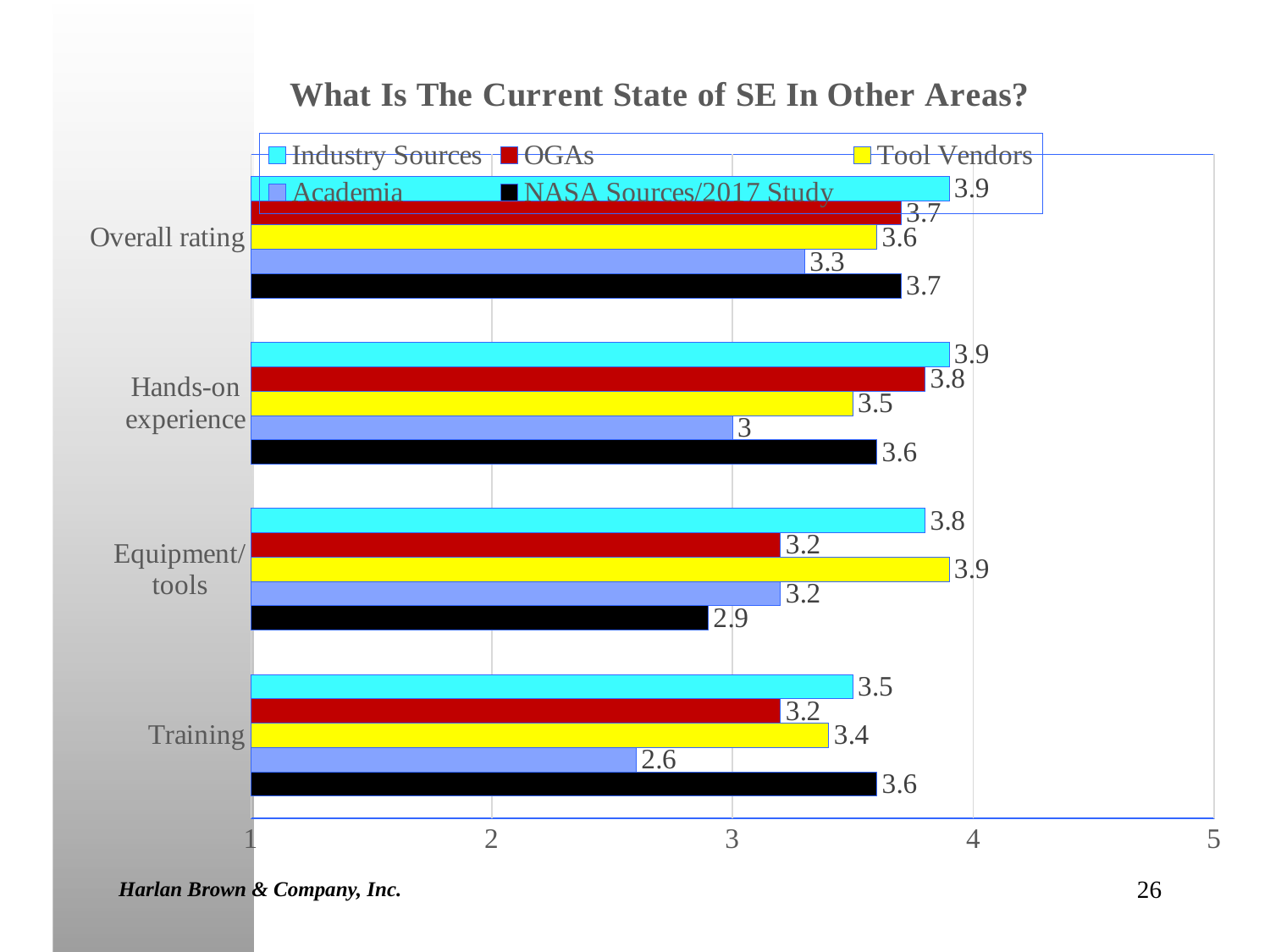
What is the Academia value for Training? 2.6 What is the difference between the Industry Sources and Academia values for Hands-on experience? 0.9 How many categories are shown on the chart? 4 For Training, which is larger: the OGAs value or the NASA Sources/2017 Study value? NASA Sources/2017 Study Which series has the highest value for Equipment/tools? Tool Vendors Which series has the lowest value for Training? Academia What is the title of the chart? What Is The Current State of SE In Other Areas? What is the Tool Vendors value for Hands-on experience? 3.5 What is the Industry Sources value for Overall rating? 3.9 What kind of chart is shown on the slide? Bar chart What is the NASA Sources/2017 Study value for Equipment/tools? 2.9 How many series does the legend list? 5